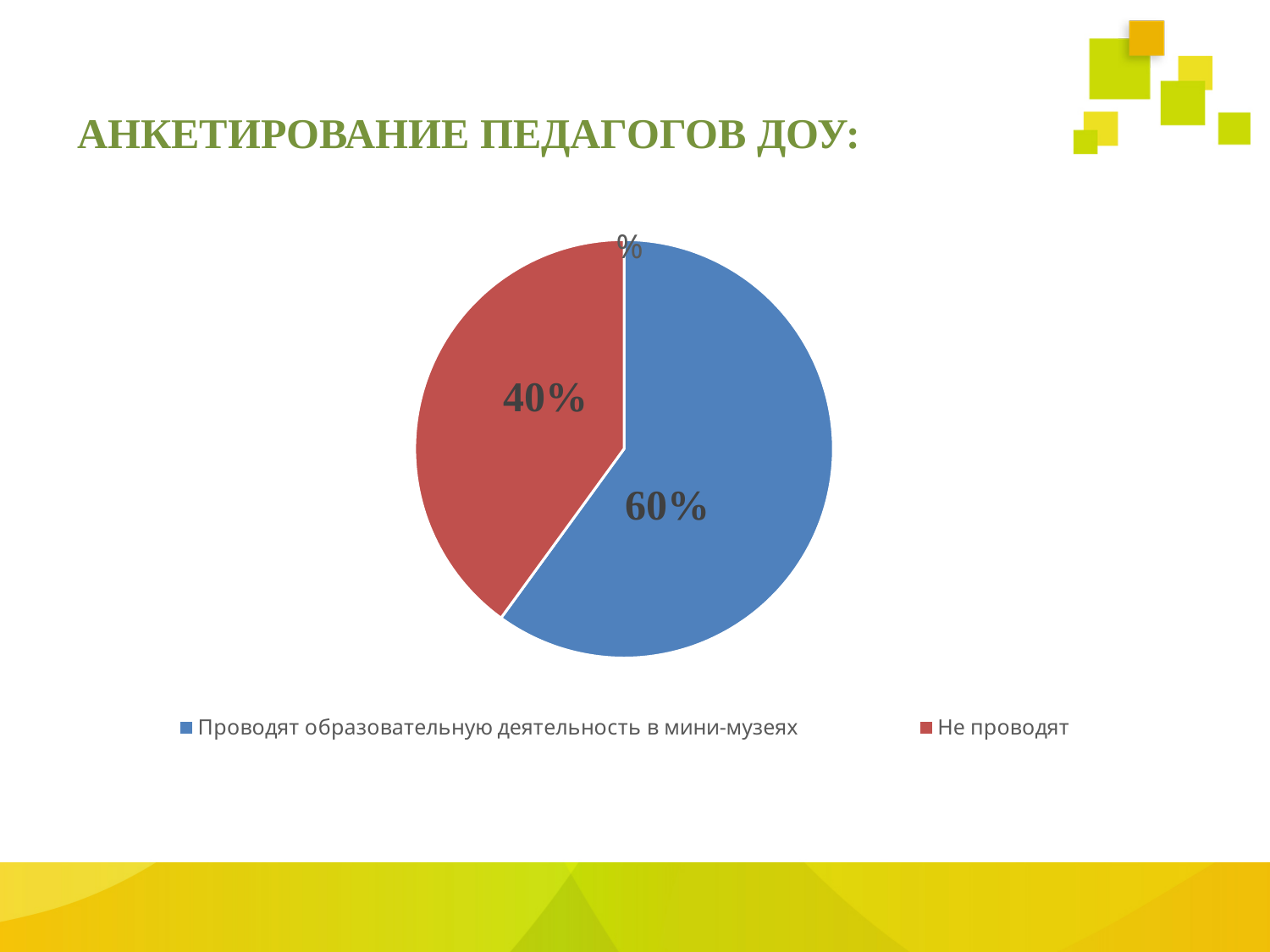
What share of the pie is labelled "Проводят образовательную деятельность в мини-музеях"? 60% What colour is the "Проводят образовательную деятельность в мини-музеях" slice? blue What share of the pie is labelled "Не проводят"? 40% What is the difference between the "Проводят образовательную деятельность в мини-музеях" slice and the "Не проводят" slice? 20% Which slice of the pie is the largest? Проводят образовательную деятельность в мини-музеях What colour is the "Не проводят" slice? red How many entries does the legend list? 2 Which slice of the pie is the smallest? Не проводят Which is larger: the "Проводят образовательную деятельность в мини-музеях" slice or the "Не проводят" slice? Проводят образовательную деятельность в мини-музеях What kind of chart is shown on the slide? pie chart How many slices does the pie chart have? 2